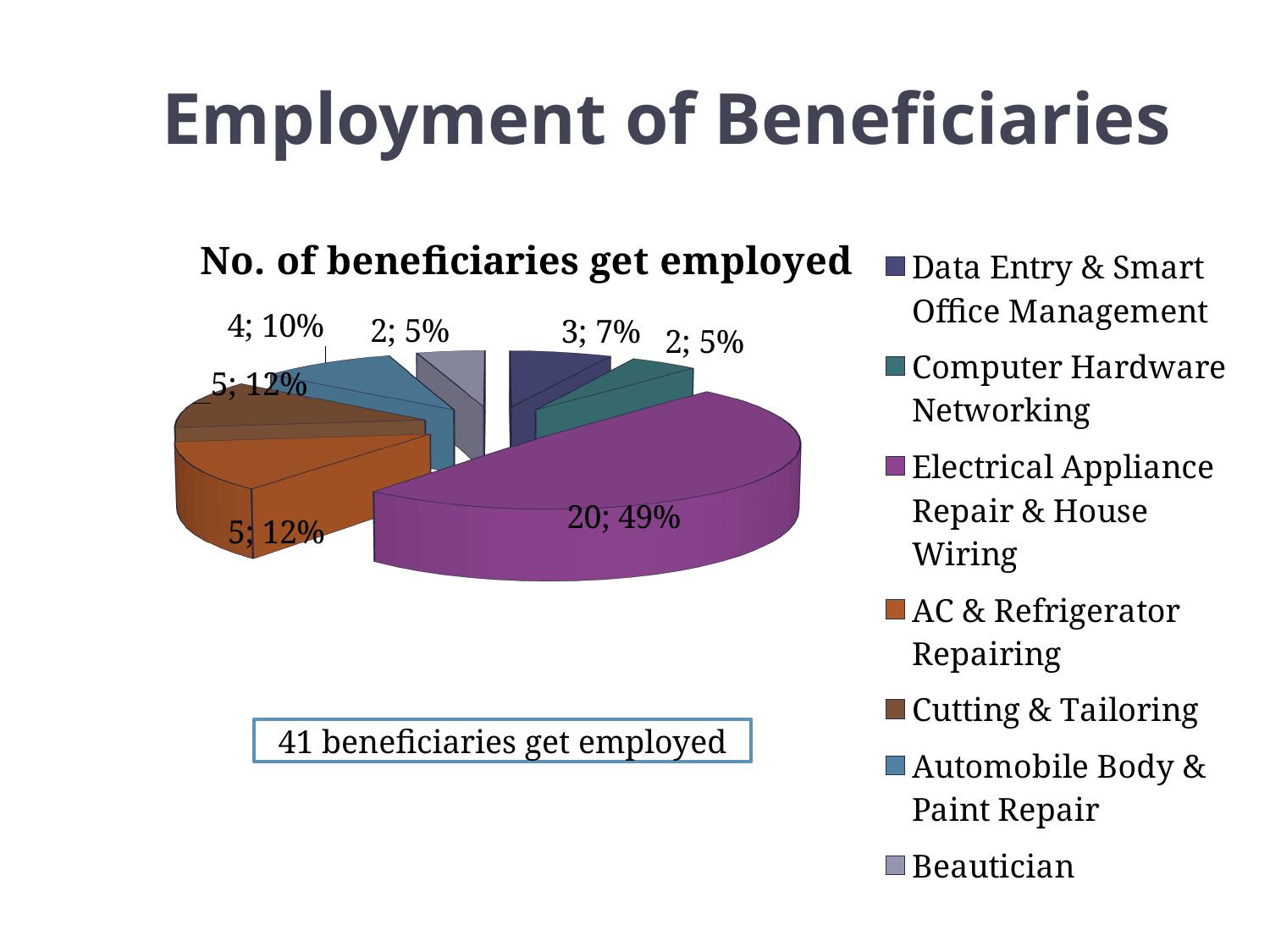
What is the difference in number of beneficiaries between Electrical Appliance Repair & House Wiring and AC & Refrigerator Repairing? 15 How many beneficiaries got employed in Electrical Appliance Repair & House Wiring? 20 What percentage of the pie is Automobile Body & Paint Repair? 10% How many categories (slices) does the pie chart have? 7 What is the total number of beneficiaries who got employed according to the slide? 41 How many beneficiaries got employed in Data Entry & Smart Office Management? 3 What is the title of the chart? No. of beneficiaries get employed Which has more beneficiaries employed: Automobile Body & Paint Repair or Data Entry & Smart Office Management? Automobile Body & Paint Repair What kind of chart is shown on the slide? Pie chart What share of the pie does Electrical Appliance Repair & House Wiring represent? 49% Which category has the largest slice of the pie? Electrical Appliance Repair & House Wiring Which two categories have the smallest slices, each with 2 beneficiaries? Computer Hardware Networking and Beautician